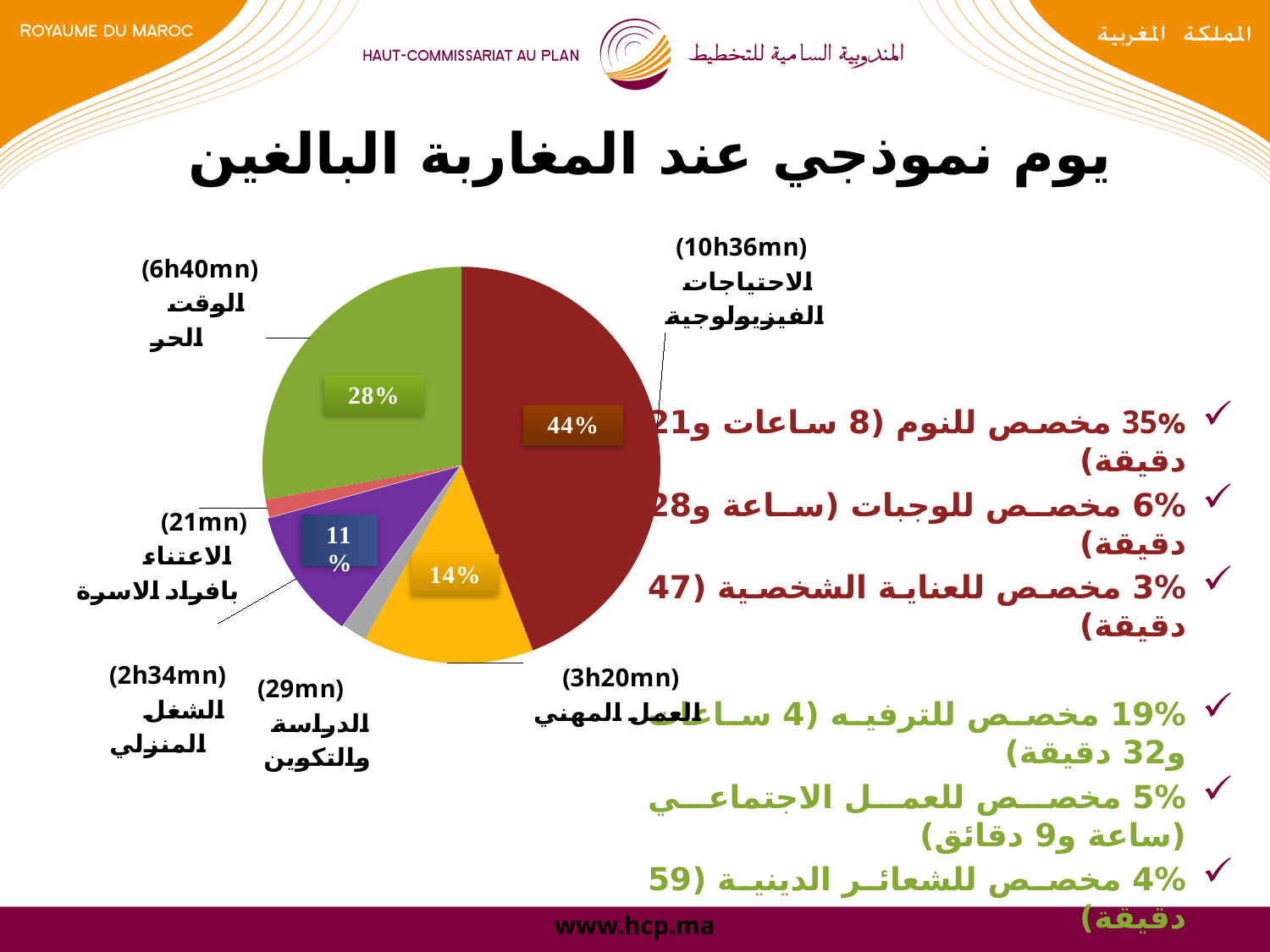
What percentage of the day is shown for الشغل المنزلي (household work)? 11% Which is larger: the share for العمل المهني or the share for الشغل المنزلي? العمل المهني What duration is given for الوقت الحر (free time)? 6h40mn What is the difference in percentage points between الاحتياجات الفيزيولوجية and الوقت الحر? 16 percentage points What percentage of the day is shown for العمل المهني (professional work)? 14% Which category takes the smallest share of the pie? الاعتناء بأفراد الأسرة (21mn) Which category takes the largest share of the pie? الاحتياجات الفيزيولوجية (10h36mn) How many slices does the pie chart have? 6 What percentage of the day is shown for الوقت الحر (free time)? 28% What duration is given for الدراسة والتكوين (study and training)? 29mn What kind of chart is shown on the slide? Pie chart What percentage of the day is shown for الاحتياجات الفيزيولوجية (physiological needs)? 44%